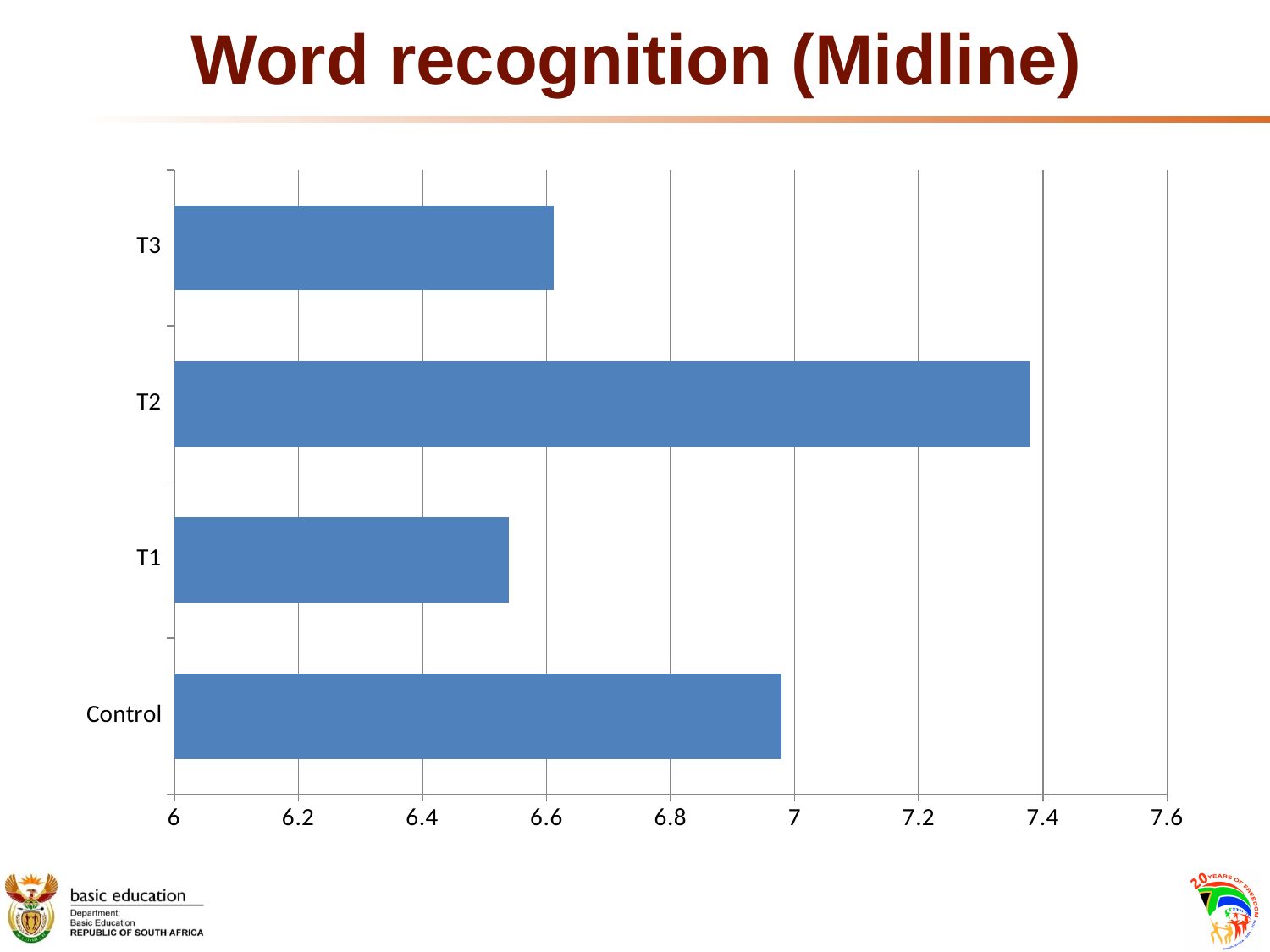
What kind of chart is shown on the slide? bar chart Which has the larger value, Control or T3? Control Is the value for Control greater or less than 6.8? greater Is the value for T2 greater or less than 7.2? greater What is the highest value shown on the horizontal axis? 7.6 Which category has the lowest value? T1 Is the value for T3 greater or less than 6.8? less What is the title of the chart? Word recognition (Midline) How many categories are plotted in the chart? 4 Which has the larger value, T2 or Control? T2 Which category has the highest value? T2